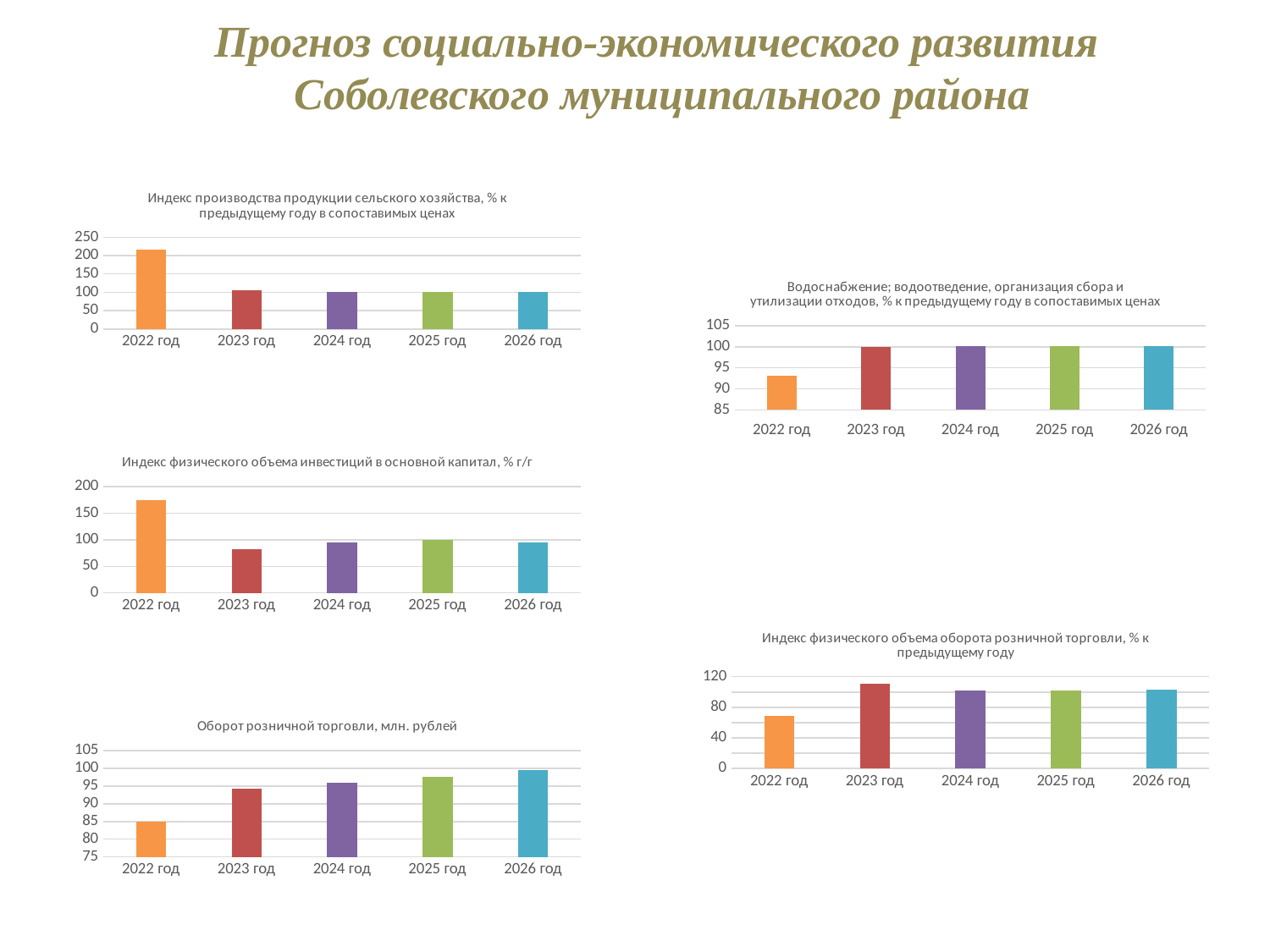
How many years are shown on the x axis of the chart 'Оборот розничной торговли, млн. рублей'? 5 In the chart 'Индекс физического объема инвестиций в основной капитал, % г/г', is the value for 2022 год greater or less than 150? greater In the chart 'Оборот розничной торговли, млн. рублей', do the values rise or fall from 2022 год to 2026 год? rise In the chart 'Водоснабжение; водоотведение, организация сбора и утилизации отходов, % к предыдущему году в сопоставимых ценах', is the value for 2022 год greater or less than 95? less In the chart 'Индекс физического объема оборота розничной торговли, % к предыдущему году', which year has the highest value? 2023 год In the chart 'Индекс физического объема инвестиций в основной капитал, % г/г', which year has the lowest value? 2023 год What kind of chart is 'Индекс физического объема инвестиций в основной капитал, % г/г'? bar chart In the chart 'Оборот розничной торговли, млн. рублей', is the value for 2022 год greater or less than 90? less In the chart 'Водоснабжение; водоотведение, организация сбора и утилизации отходов, % к предыдущему году в сопоставимых ценах', which year has the lowest value? 2022 год In the chart 'Индекс физического объема оборота розничной торговли, % к предыдущему году', which is larger, the value for 2022 год or 2024 год? 2024 год In the chart 'Индекс производства продукции сельского хозяйства, % к предыдущему году в сопоставимых ценах', which year has the highest value? 2022 год